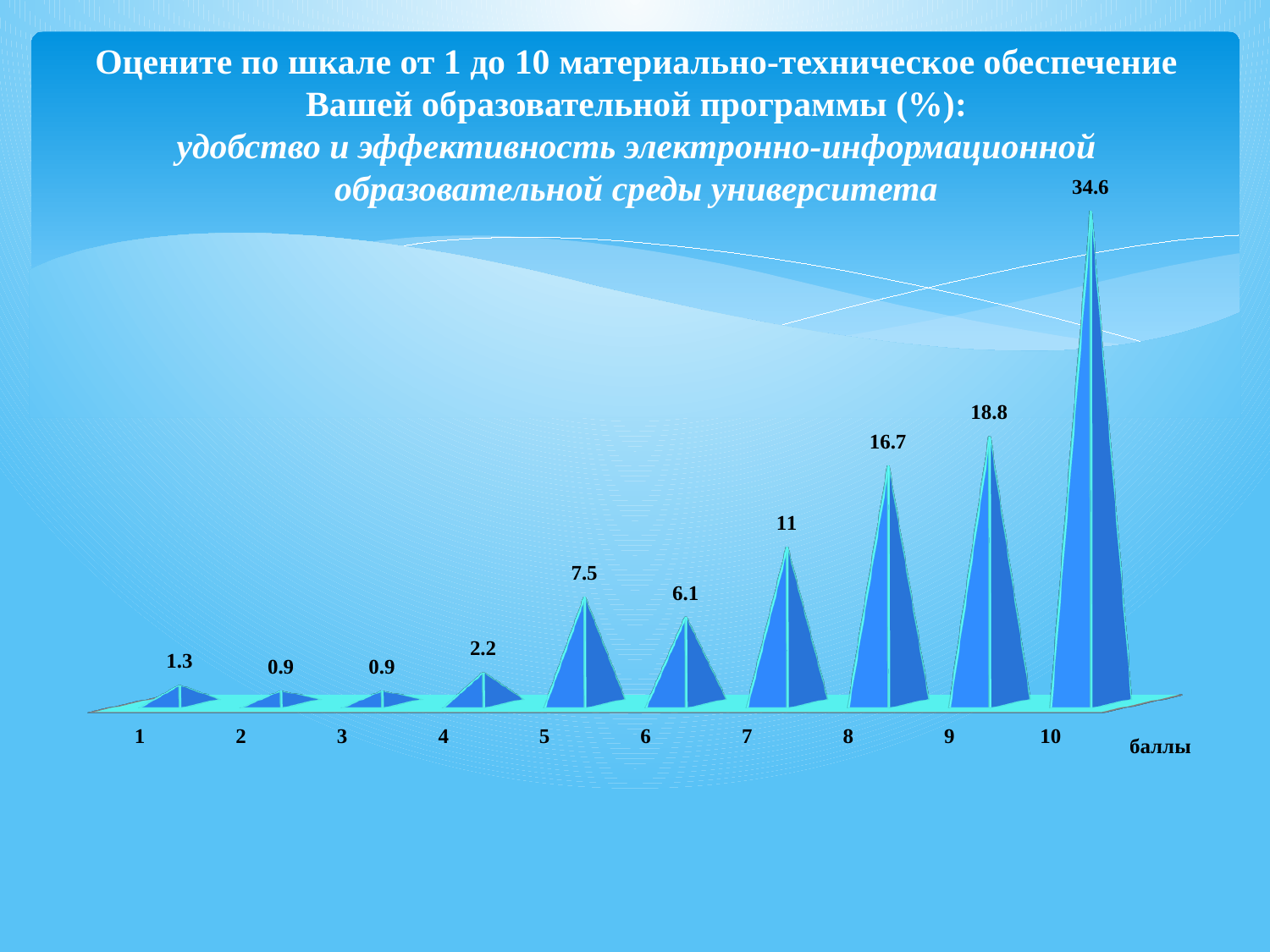
How many score categories are shown on the x axis? 10 What is the value for score 5? 7.5 Which is larger, the value for score 5 or the value for score 6? score 5 What is the value for score 10? 34.6 What is the value for score 1? 1.3 What kind of chart is shown on the slide? bar chart Do the values generally rise or fall from score 4 to score 10? rise What is the difference between the values for score 10 and score 9? 15.8 What is the value for score 8? 16.7 What is the lowest value shown on the chart? 0.9 Which score has the highest value? 10 What is the label of the x axis? баллы